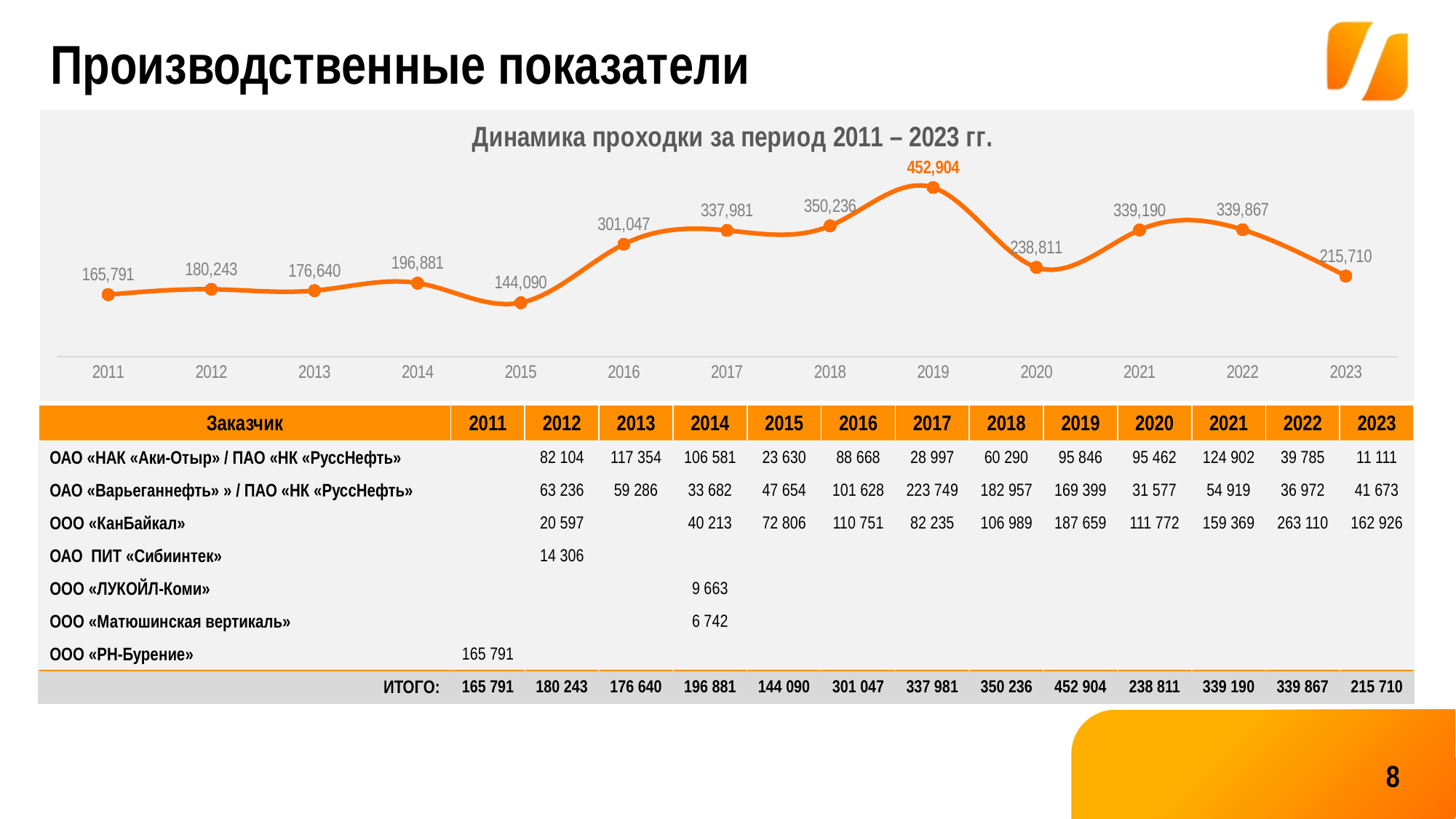
Do the values on the line chart rise or fall from 2015 to 2019? Rise Which year has the highest value on the line chart? 2019 What is the difference between the values for 2019 and 2020 on the line chart? 214,093 What is the value for 2023 on the line chart? 215,710 What kind of chart is shown on the slide? Line chart What is the value for 2015 on the line chart? 144,090 What is the value for 2011 on the line chart? 165,791 How many years are plotted on the line chart? 13 What is the difference between the values for 2016 and 2015 on the line chart? 156,957 Which year has the larger value on the line chart, 2018 or 2020? 2018 Which year has the lowest value on the line chart? 2015 What is the value for 2019 on the line chart? 452,904